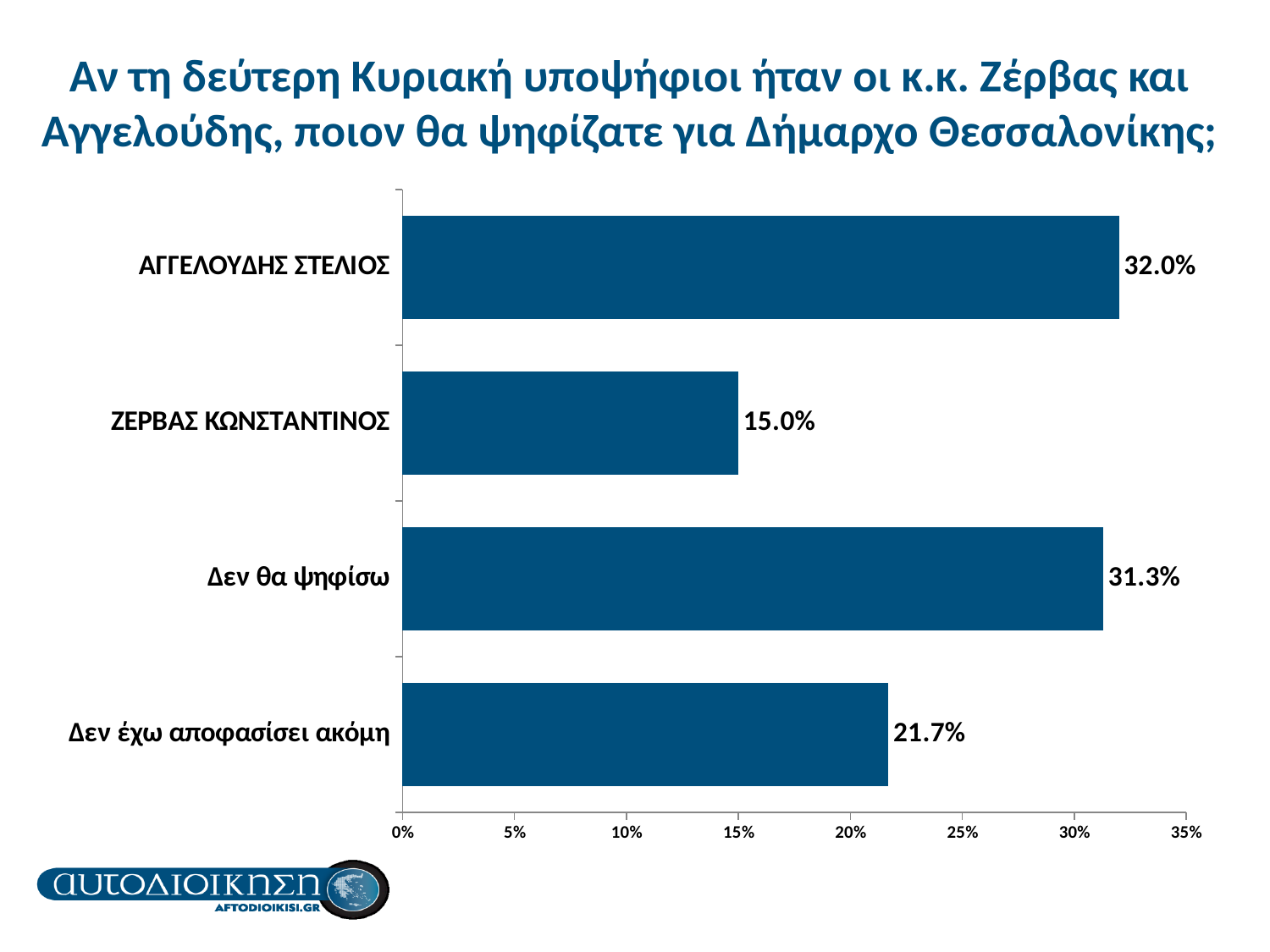
What kind of chart is shown on the slide? bar chart What is the value for Δεν θα ψηφίσω? 31.3% How many categories are shown in the chart? 4 What is the value for Δεν έχω αποφασίσει ακόμη? 21.7% What is the difference between the values for Δεν θα ψηφίσω and Δεν έχω αποφασίσει ακόμη? 9.6% Which category has the lowest value? ΖΕΡΒΑΣ ΚΩΝΣΤΑΝΤΙΝΟΣ What is the value for ΖΕΡΒΑΣ ΚΩΝΣΤΑΝΤΙΝΟΣ? 15.0% Is the value for Δεν έχω αποφασίσει ακόμη greater or less than 20%? greater Which category has the highest value? ΑΓΓΕΛΟΥΔΗΣ ΣΤΕΛΙΟΣ What is the value for ΑΓΓΕΛΟΥΔΗΣ ΣΤΕΛΙΟΣ? 32.0% Which is larger, the value for Δεν έχω αποφασίσει ακόμη or the value for ΖΕΡΒΑΣ ΚΩΝΣΤΑΝΤΙΝΟΣ? Δεν έχω αποφασίσει ακόμη What is the difference between the values for ΑΓΓΕΛΟΥΔΗΣ ΣΤΕΛΙΟΣ and ΖΕΡΒΑΣ ΚΩΝΣΤΑΝΤΙΝΟΣ? 17.0%